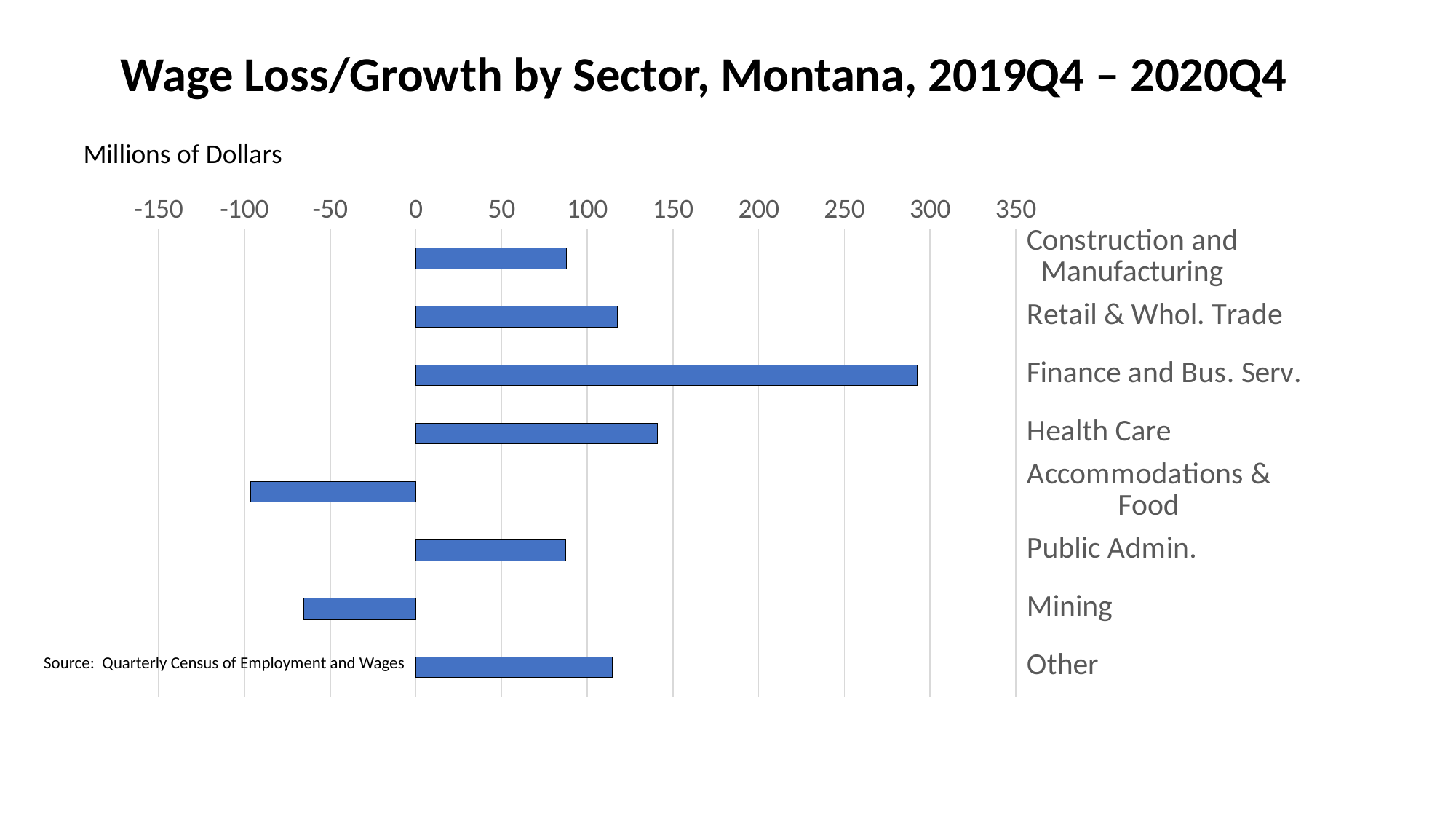
Is the value for Health Care greater or less than 100? greater Which sector shows a larger wage loss, Mining or Accommodations & Food? Accommodations & Food How many sectors are plotted in the chart? 8 Is the value for Accommodations & Food greater or less than -50? less What kind of chart is shown on the slide? bar chart Which sector has the lowest value (largest wage loss) in the chart? Accommodations & Food Which sector has the highest wage growth in the chart? Finance and Bus. Serv. Is the value for Finance and Bus. Serv. greater or less than 250? greater Which is larger, the value for Health Care or the value for Retail & Whol. Trade? Health Care What unit is the chart's axis measured in, according to the label above the chart? Millions of Dollars